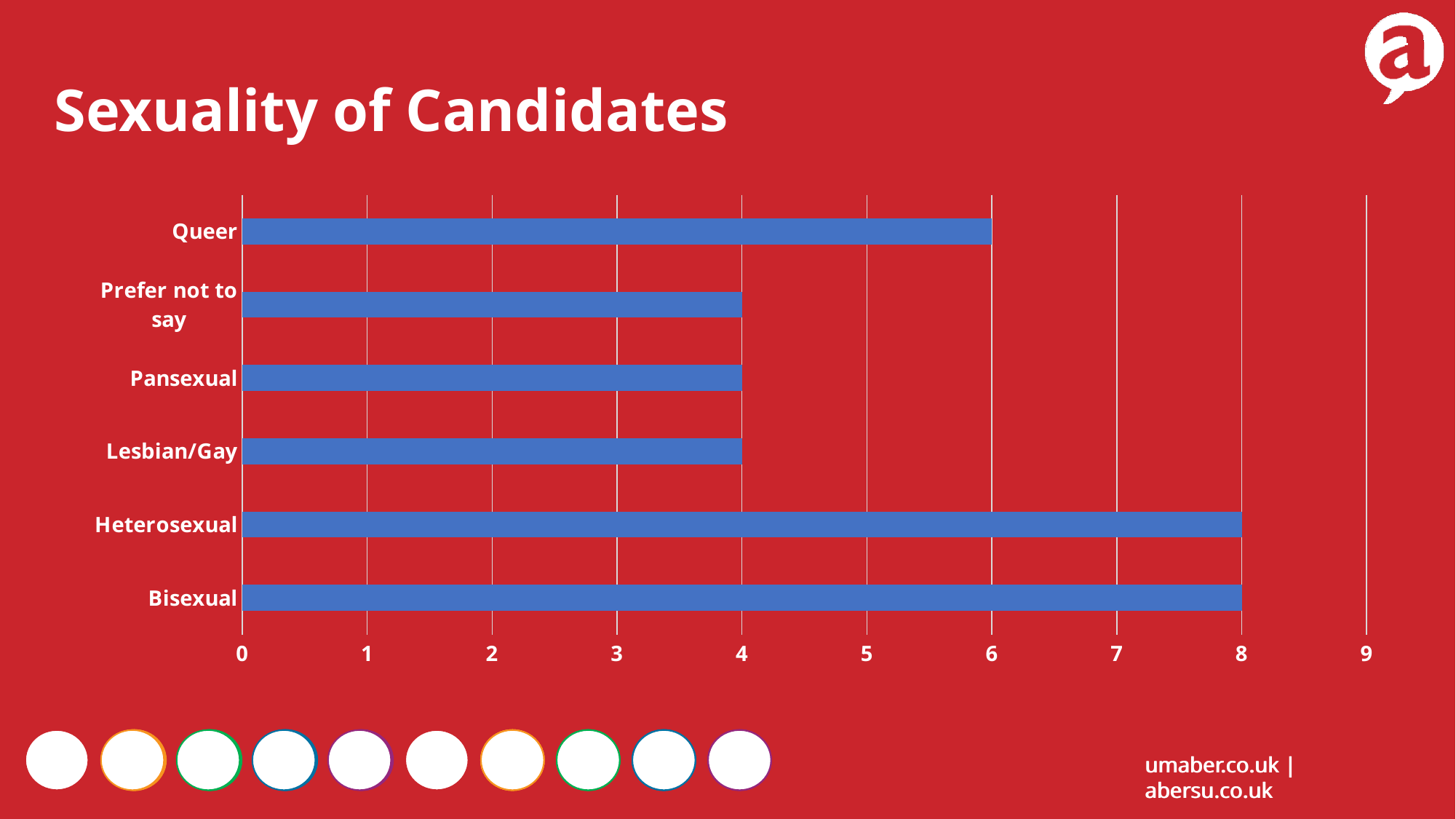
How many categories are shown in the chart? 6 Which is larger, the value for Lesbian/Gay or the value for Bisexual? Bisexual What is the value for Queer? 6 What kind of chart is shown on the slide? bar chart What is the value for Pansexual? 4 What is the difference between the values for Heterosexual and Queer? 2 What is the value for Heterosexual? 8 What is the value for Bisexual? 8 Is the value for Queer greater or less than 5? greater Which is larger, the value for Queer or the value for Pansexual? Queer What is the difference between the values for Queer and Lesbian/Gay? 2 What is the value for Prefer not to say? 4